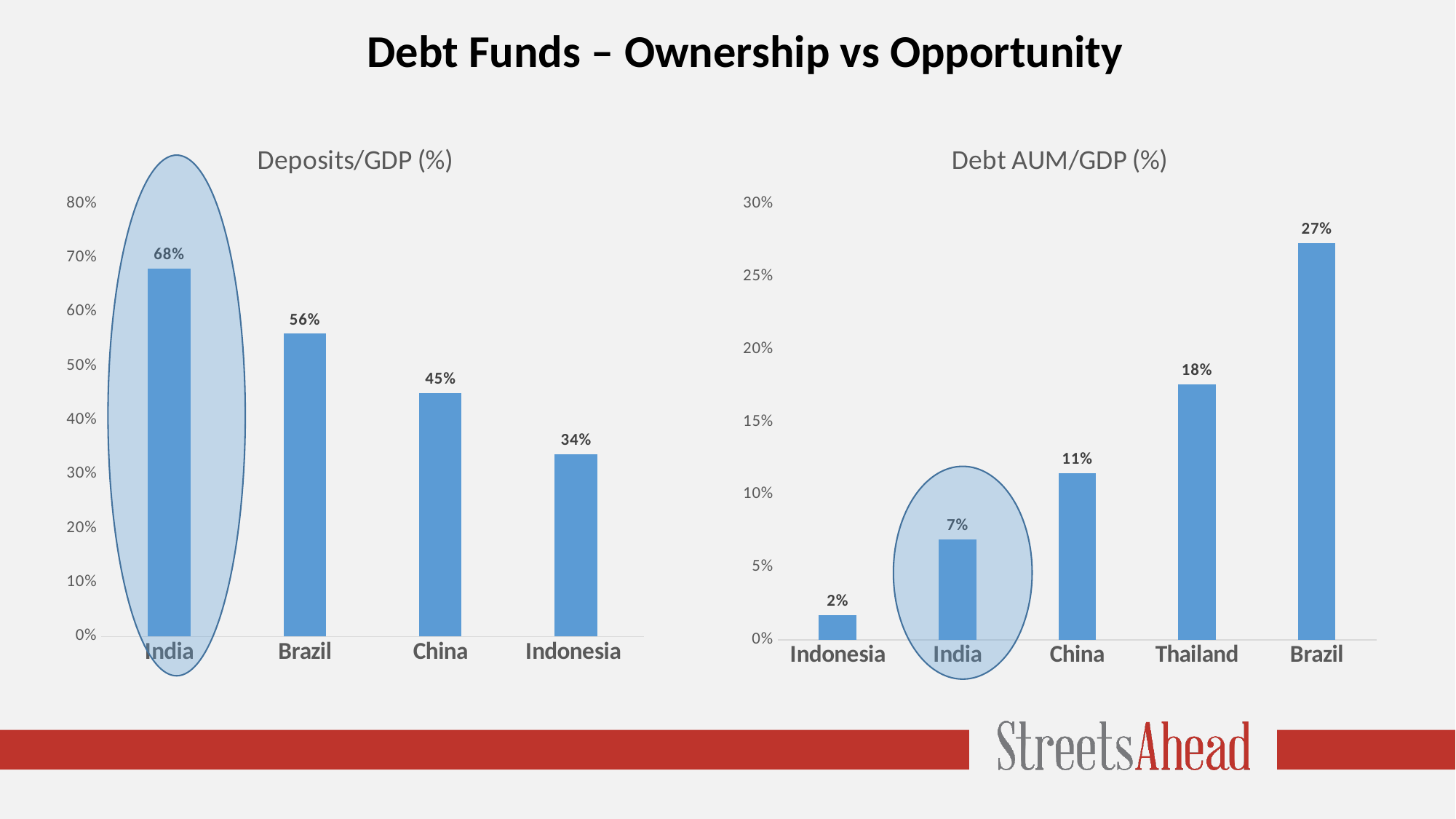
In the Debt AUM/GDP (%) chart, what is the value for Thailand? 18% What kind of chart is the Deposits/GDP (%) chart? Bar chart How many countries are shown in the Debt AUM/GDP (%) chart? 5 In the Debt AUM/GDP (%) chart, which is larger, the value for China or the value for India? China In the Deposits/GDP (%) chart, what is the difference between Brazil and China? 11% In the Deposits/GDP (%) chart, what is the value for India? 68% In the Deposits/GDP (%) chart, do the values rise or fall from left to right? Fall In the Debt AUM/GDP (%) chart, which country has the highest value? Brazil In the Debt AUM/GDP (%) chart, what is the difference between Brazil and India? 20% What is the title of the slide? Debt Funds – Ownership vs Opportunity In the Deposits/GDP (%) chart, which country has the lowest value? Indonesia How many countries are shown in the Deposits/GDP (%) chart? 4